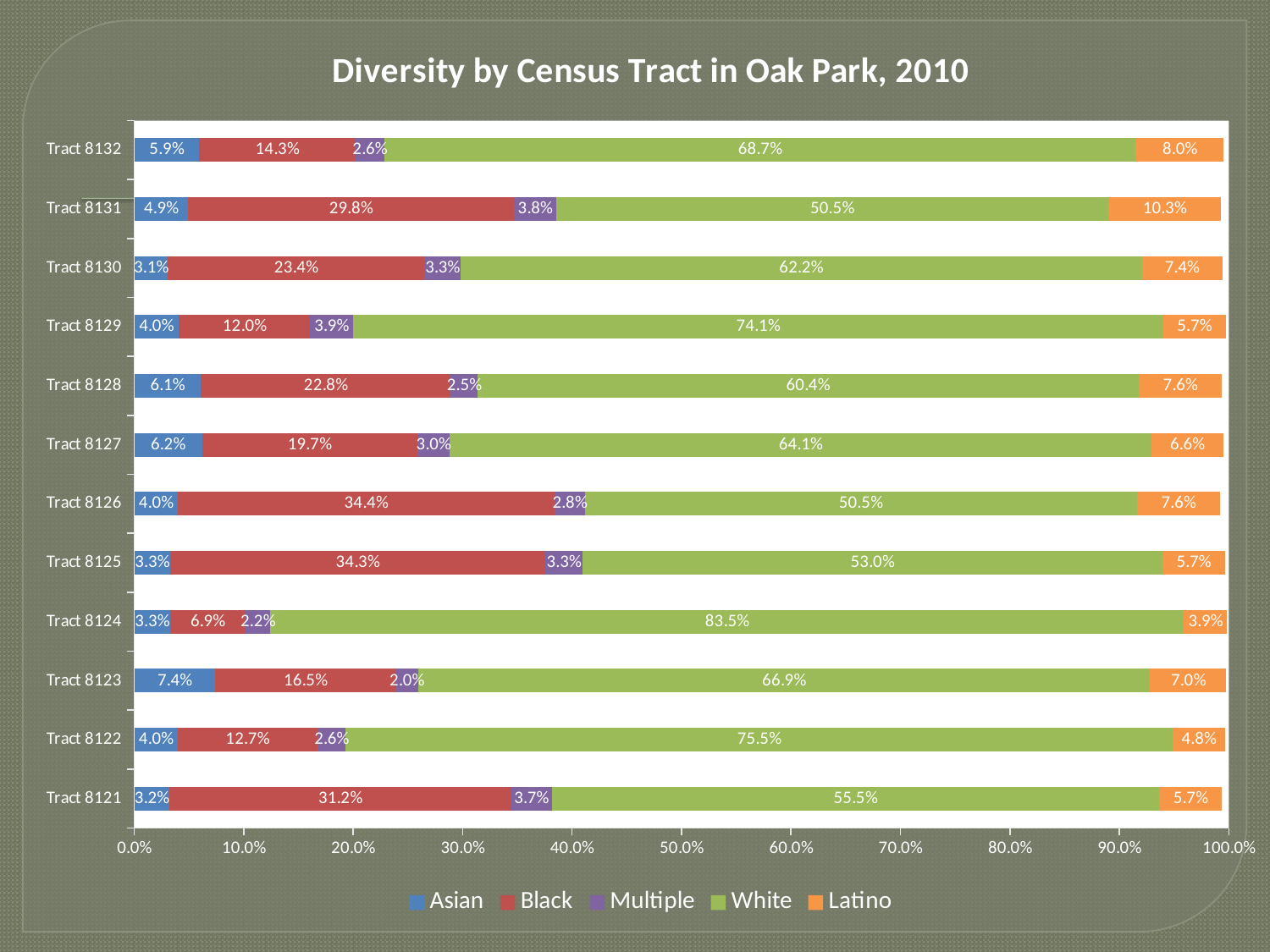
What percentage of Tract 8124 is White? 83.5% What is the Black share for Tract 8131? 29.8% What is the Asian percentage for Tract 8123? 7.4% What type of chart is shown on the slide? Stacked bar chart How many series does the legend list? 5 How many percentage points higher is the White share in Tract 8124 than in Tract 8131? 33.0 How many census tracts are shown in the chart? 12 Which census tract has the highest Latino percentage? Tract 8131 What is the Latino value for Tract 8132? 8.0% Which has a larger Black share, Tract 8131 or Tract 8130? Tract 8131 Which census tract has the lowest Black percentage? Tract 8124 Which census tract has the highest White percentage? Tract 8124